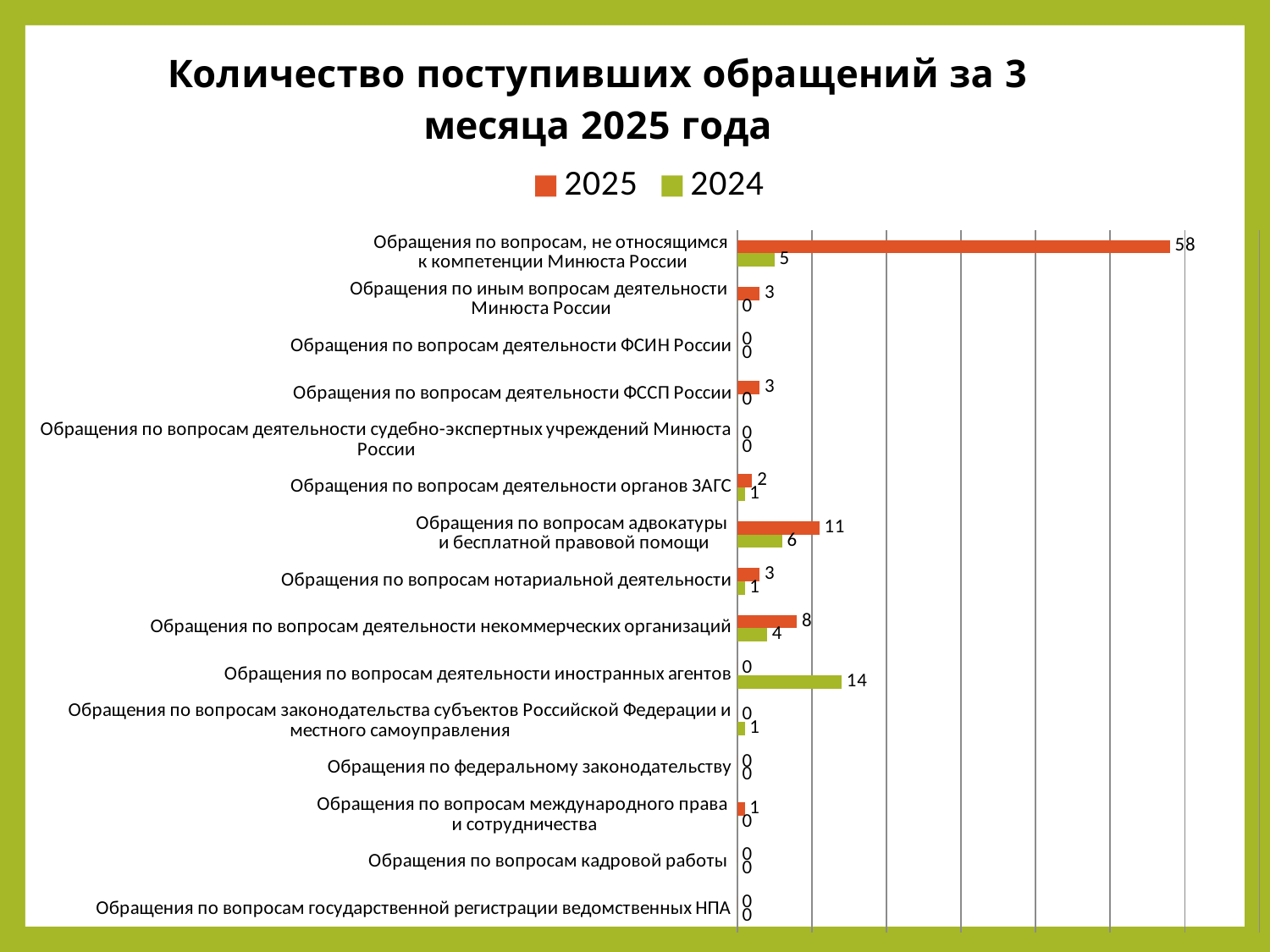
What is the difference between the 2025 and 2024 values for "Обращения по вопросам деятельности некоммерческих организаций"? 4 What is the difference between the 2025 and 2024 values for "Обращения по вопросам адвокатуры и бесплатной правовой помощи"? 5 What is the 2025 value for "Обращения по вопросам, не относящимся к компетенции Минюста России"? 58 For "Обращения по вопросам деятельности иностранных агентов", which series has the larger value, 2025 or 2024? 2024 What is the 2024 value for "Обращения по вопросам деятельности иностранных агентов"? 14 How many series does the legend list? 2 Which colour represents the 2024 series in the legend? green How many categories are plotted on the chart? 15 What kind of chart is shown on the slide? bar chart Which category has the highest 2024 value? Обращения по вопросам деятельности иностранных агентов Which category has the highest 2025 value? Обращения по вопросам, не относящимся к компетенции Минюста России What is the 2025 value for "Обращения по вопросам адвокатуры и бесплатной правовой помощи"? 11